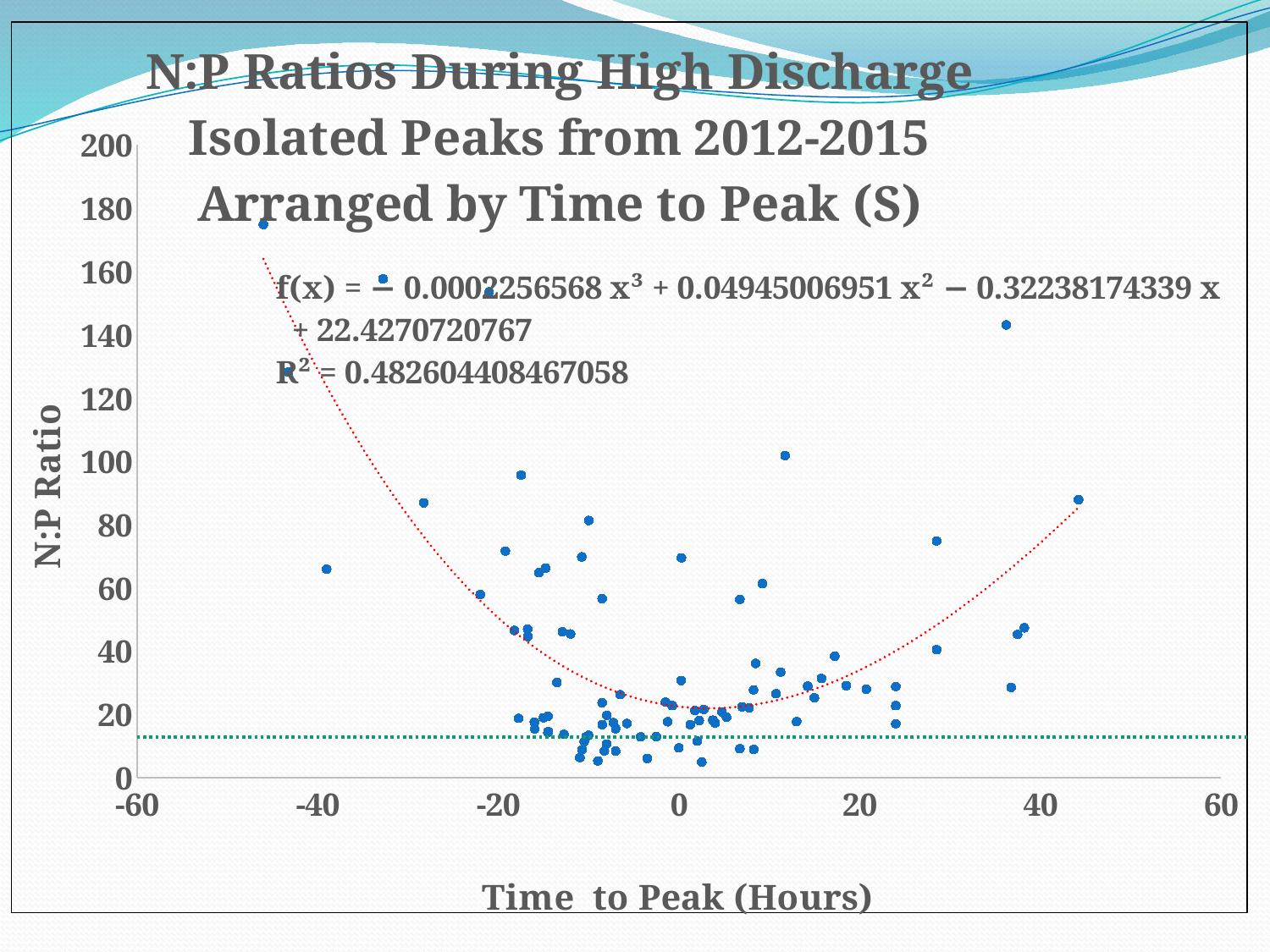
Is the N:P ratio of the leftmost plotted point (near -45 hours) greater or less than 160? greater What kind of chart is shown on the slide? scatter chart Is the highest plotted N:P ratio greater or less than 160? greater What is the title of the x axis? Time to Peak (Hours) What is the title of the y axis? N:P Ratio What is the maximum value shown on the x axis? 60 Does the fitted dotted curve fall or rise as time to peak goes from -40 hours to 0 hours? falls What R² value is printed for the fitted curve? 0.482604408467058 What is the constant term in the printed fitted equation f(x)? 22.4270720767 Is the lowest plotted N:P ratio greater or less than 20? less What is the coefficient of x³ in the printed fitted equation? -0.0002256568